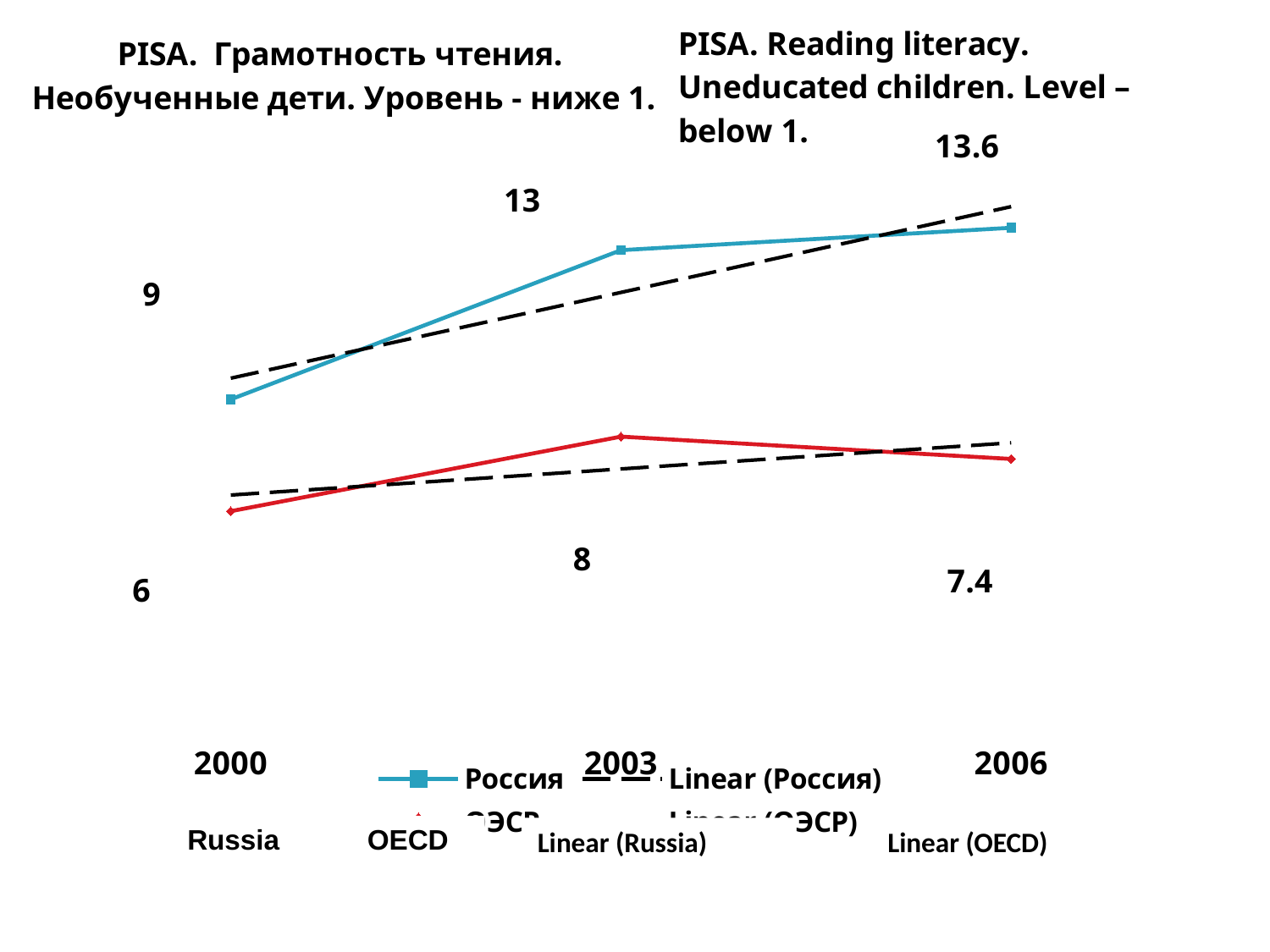
What is the value for OECD in 2000? 6 What is the difference between the Russia and OECD values in 2006? 6.2 What is the value for OECD in 2003? 8 In which year is the OECD value lowest? 2000 What type of chart is shown on the slide? line chart Which is larger in 2003, the Russia value or the OECD value? Russia How many years are shown on the x axis? 3 In which year is the Russia value highest? 2006 What is the value for Russia in 2003? 13 What is the value for Russia in 2006? 13.6 What is the value for OECD in 2006? 7.4 What is the value for Russia in 2000? 9